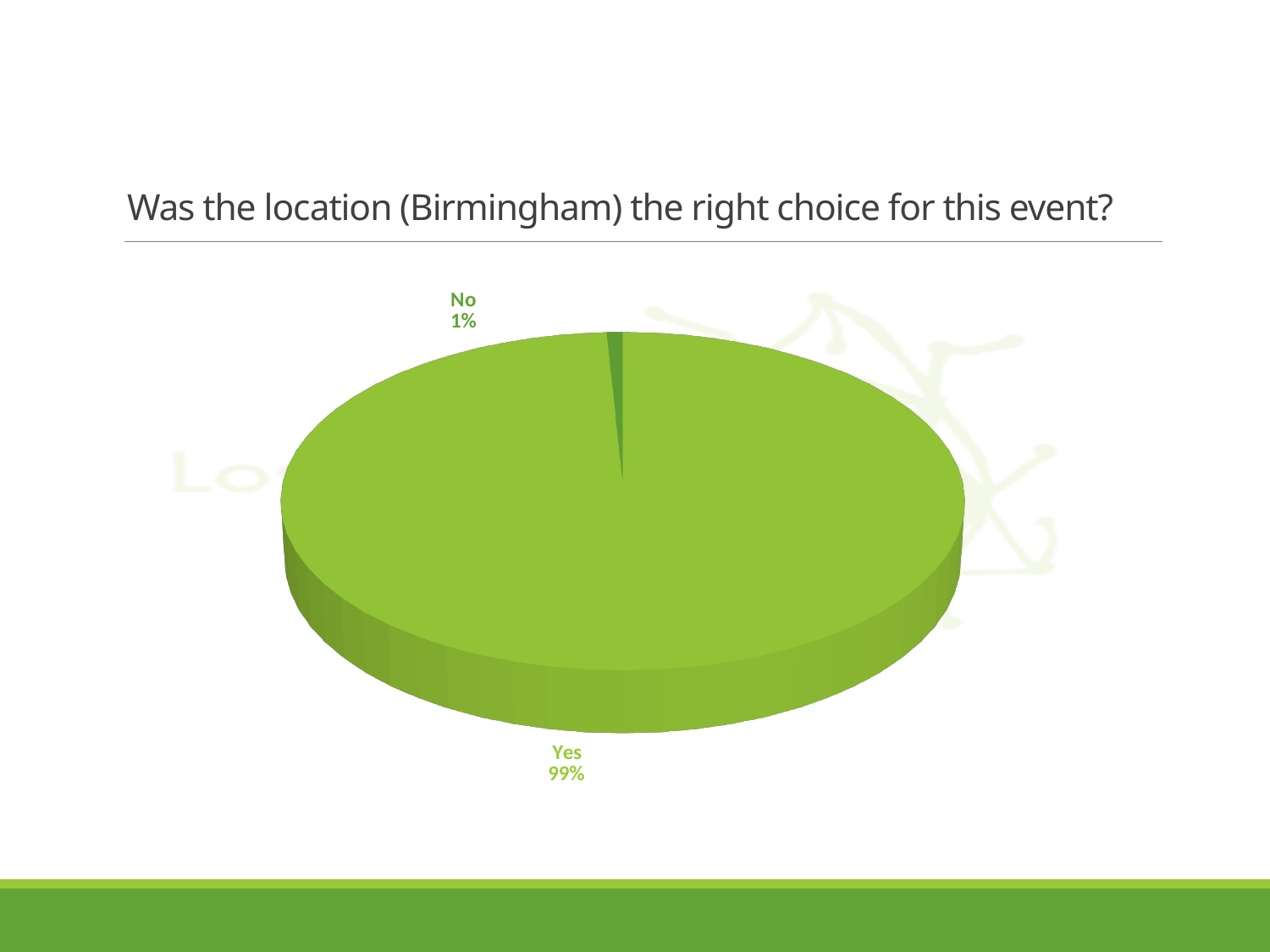
What share of the pie does the Yes slice represent? 99% What kind of chart is shown on the slide? Pie chart What is the title of the chart? Was the location (Birmingham) the right choice for this event? Which response has the smallest share of the pie? No Which is larger, the share for Yes or the share for No? Yes How many slices does the pie chart have? 2 What percentage of respondents answered Yes? 99% Which response has the largest share of the pie? Yes Is the share for Yes greater or less than 50%? greater What percentage of respondents answered No? 1% What is the difference in percentage points between the Yes and No shares? 98